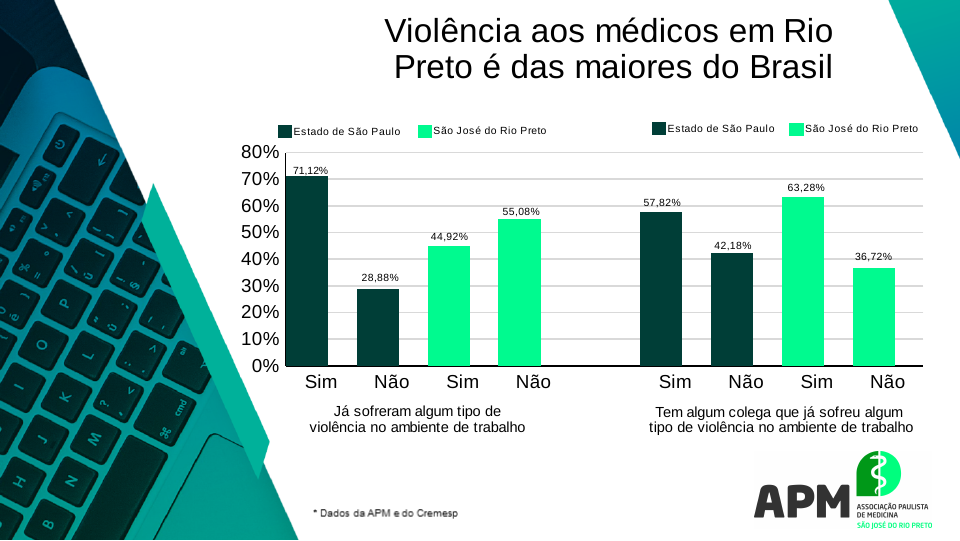
In the left chart (Já sofreram algum tipo de violência no ambiente de trabalho), what is the value for Não for São José do Rio Preto? 55,08% How many series does the legend of the left chart list? 2 In the right chart (Tem algum colega que já sofreu algum tipo de violência no ambiente de trabalho), which bar has the lowest value? Não, São José do Rio Preto In the left chart (Já sofreram algum tipo de violência no ambiente de trabalho), which bar has the lowest value? Não, Estado de São Paulo In the right chart (Tem algum colega que já sofreu algum tipo de violência no ambiente de trabalho), what is the value for Sim for São José do Rio Preto? 63,28% What kind of chart is shown on the slide? Bar chart In the left chart (Já sofreram algum tipo de violência no ambiente de trabalho), which bar has the highest value? Sim, Estado de São Paulo In the right chart (Tem algum colega que já sofreu algum tipo de violência no ambiente de trabalho), what is the difference between Sim and Não for Estado de São Paulo? 15,64% In the left chart (Já sofreram algum tipo de violência no ambiente de trabalho), what is the difference between the Sim values for Estado de São Paulo and São José do Rio Preto? 26,20% In the right chart (Tem algum colega que já sofreu algum tipo de violência no ambiente de trabalho), what is the value for Não for Estado de São Paulo? 42,18% In the left chart (Já sofreram algum tipo de violência no ambiente de trabalho), what is the value for Sim for Estado de São Paulo? 71,12% In the right chart (Tem algum colega que já sofreu algum tipo de violência no ambiente de trabalho), which is larger: Sim for Estado de São Paulo or Sim for São José do Rio Preto? Sim for São José do Rio Preto